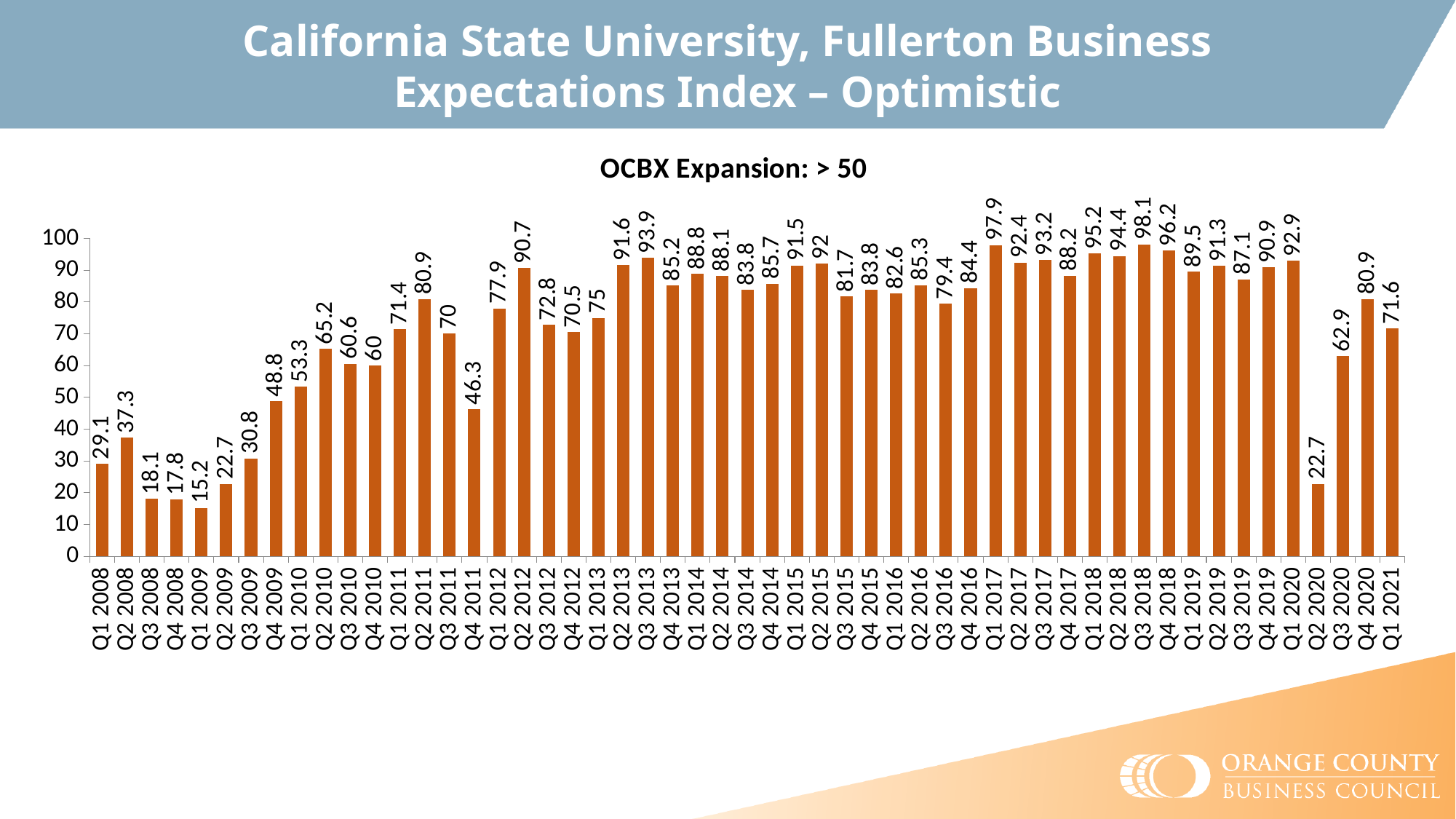
Is the value for Q3 2020 greater or less than 50? greater Which quarter has the lowest value? Q1 2009 Do the values rise or fall from Q2 2020 to Q4 2020? rise What is the subtitle shown above the chart? OCBX Expansion: > 50 What is the value for Q1 2021? 71.6 What is the value for Q2 2020? 22.7 Which quarter has the highest value? Q3 2018 Which is larger, the value for Q4 2020 or the value for Q1 2021? Q4 2020 What is the value for Q1 2017? 97.9 What kind of chart is shown on the slide? bar chart What is the difference between the values for Q1 2020 and Q2 2020? 70.2 How many quarters are plotted on the chart? 53